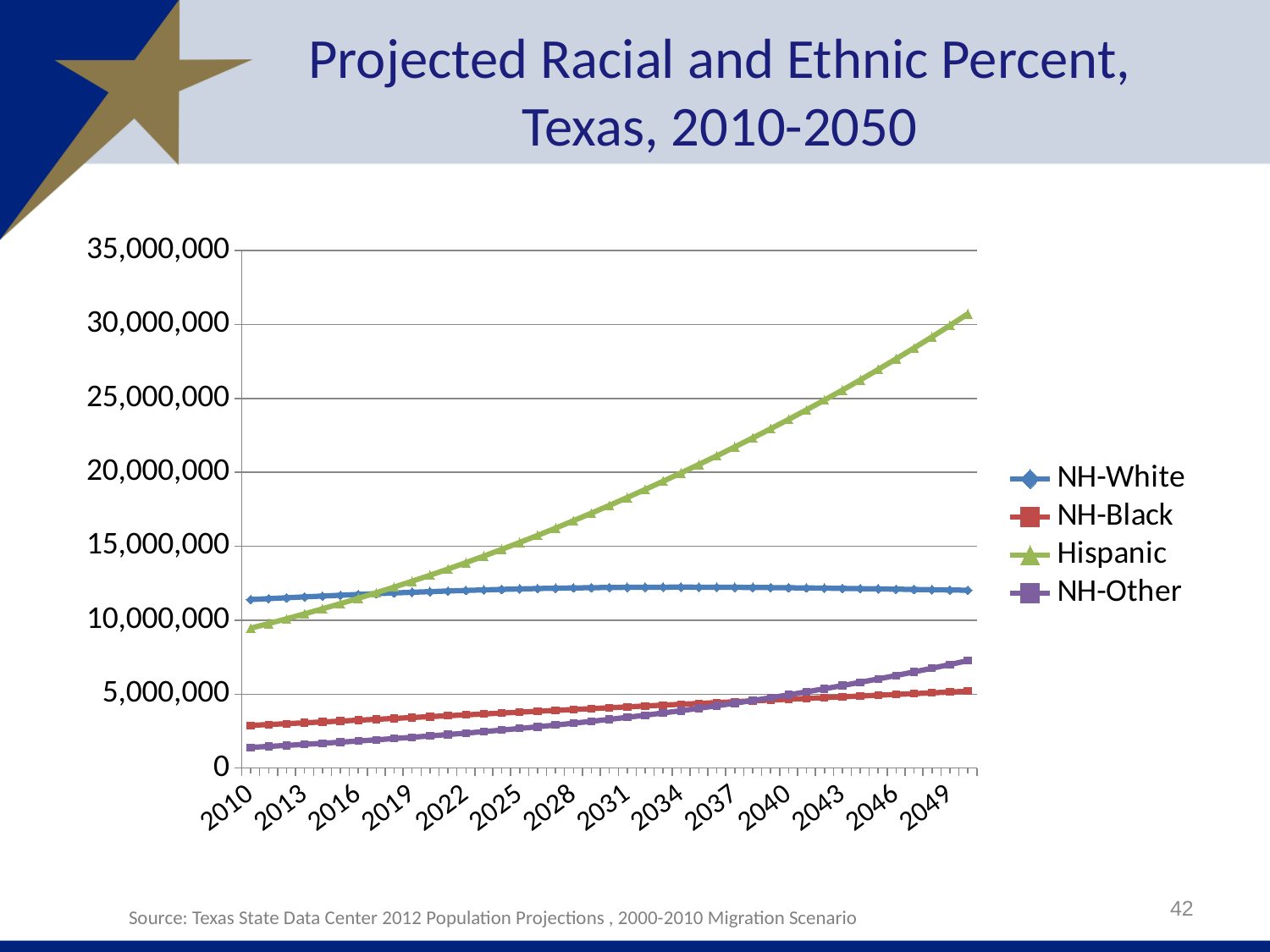
What is the title of the chart? Projected Racial and Ethnic Percent, Texas, 2010-2050 Does the NH-Other series rise or fall from 2010 to 2049? rise Does the Hispanic series rise or fall from 2010 to 2049? rise Which series has the lowest value in 2010? NH-Other Which is larger in 2049, Hispanic or NH-White? Hispanic What kind of chart is shown on the slide? line chart Which is larger in 2010, NH-Black or NH-Other? NH-Black Which series has the highest value in 2049? Hispanic Is the value for NH-White in 2010 greater or less than 10,000,000? greater Is the value for Hispanic in 2010 greater or less than 10,000,000? less Is the value for Hispanic in 2040 greater or less than 20,000,000? greater How many series does the legend list? 4